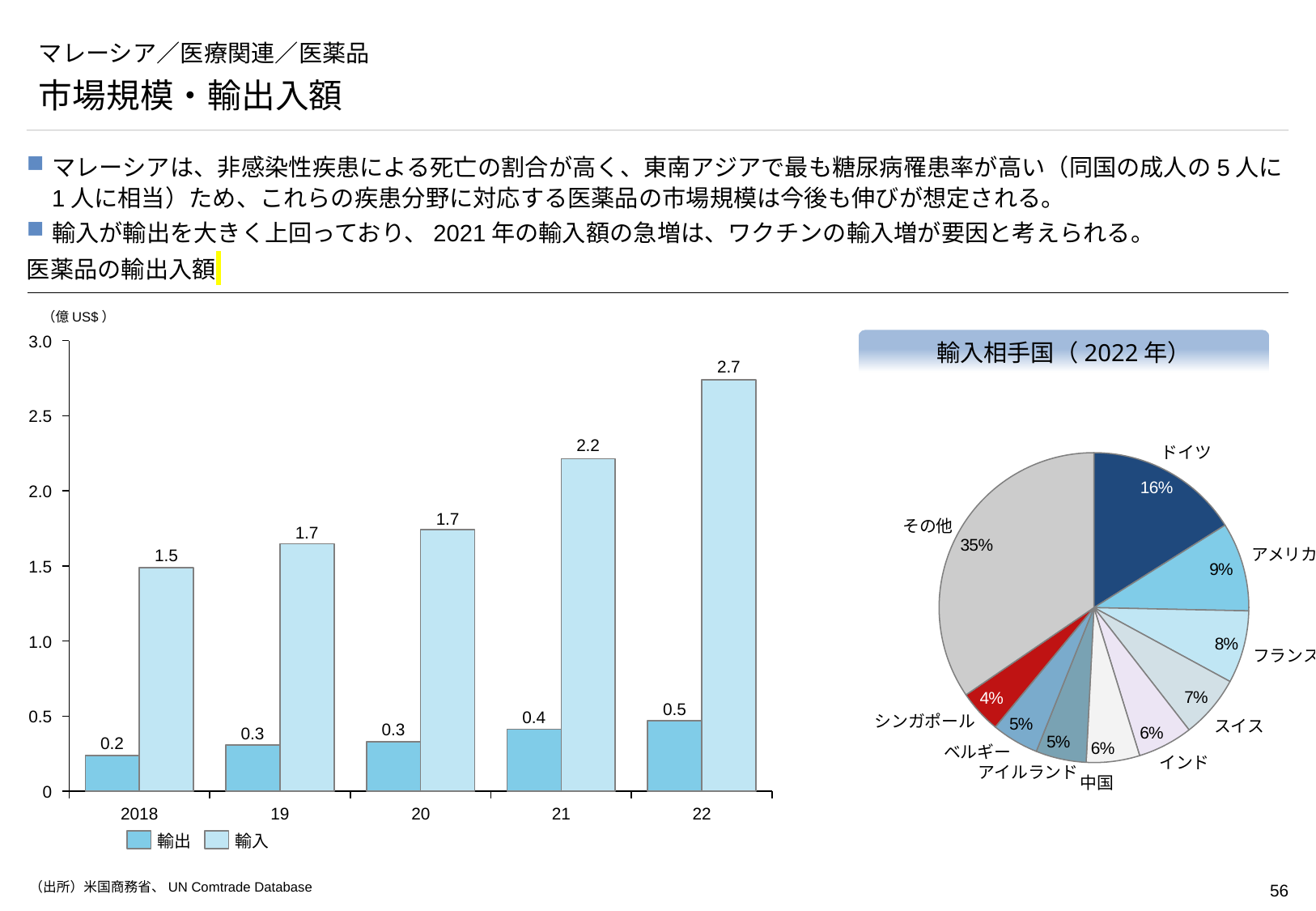
In the pie chart 輸入相手国（2022年）, which named country (excluding その他) has the largest share? ドイツ In the pie chart 輸入相手国（2022年）, which is larger, the share for アメリカ or the share for フランス? アメリカ In the bar chart 医薬品の輸出入額, what is the 輸入 value for 2022? 2.7 In the pie chart 輸入相手国（2022年）, what share does ドイツ have? 16% In the bar chart 医薬品の輸出入額, which year has the highest 輸入 value? 22 In the bar chart 医薬品の輸出入額, what is the 輸出 value for 2018? 0.2 In the bar chart 医薬品の輸出入額, how many years are shown on the x axis? 5 In the bar chart 医薬品の輸出入額, what is the difference between 輸入 and 輸出 in 2021? 1.8 In the bar chart 医薬品の輸出入額, do the 輸入 values rise or fall from 2018 to 2022? rise What kind of chart is 医薬品の輸出入額? bar chart In the bar chart 医薬品の輸出入額, how many series does the legend list? 2 In the pie chart 輸入相手国（2022年）, which slice is the smallest? シンガポール